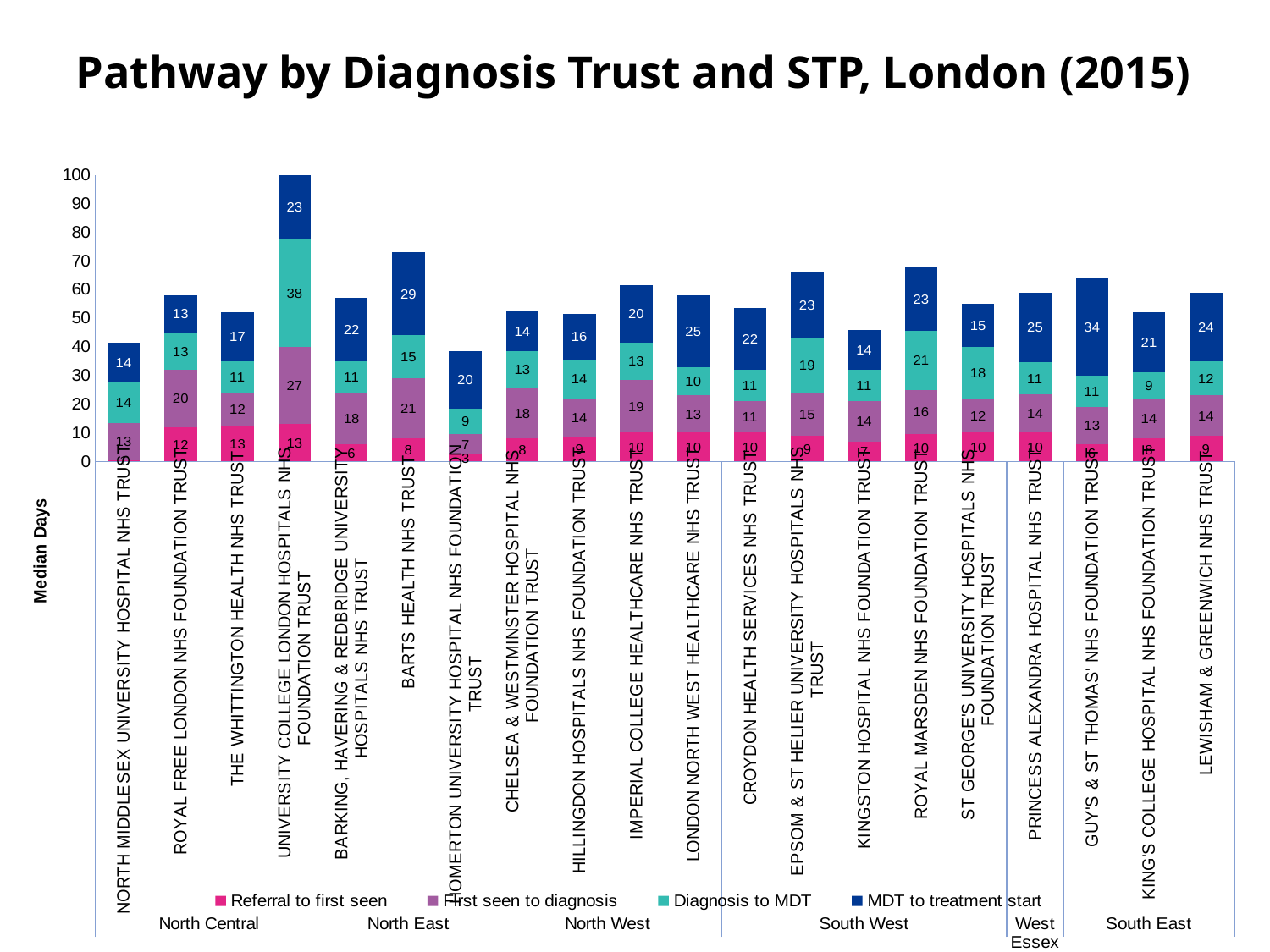
What is the First seen to diagnosis value for Royal Free London NHS Foundation Trust? 20 Which trust has the tallest stacked bar overall? University College London Hospitals NHS Foundation Trust Which trust has the smallest Referral to first seen value? North Middlesex University Hospital NHS Trust What kind of chart is shown on the slide? Stacked bar chart What is the MDT to treatment start value for Guy's & St Thomas' NHS Foundation Trust? 34 How many trusts are plotted along the x axis? 20 What is the difference between the MDT to treatment start values for Barts Health NHS Trust and Barking, Havering & Redbridge University Hospitals NHS Trust? 7 How many series does the legend list? 4 Is the total stacked bar for Homerton University Hospital NHS Foundation Trust greater or less than 50? less What is the Diagnosis to MDT value for University College London Hospitals NHS Foundation Trust? 38 Which has the larger MDT to treatment start value: Imperial College Healthcare NHS Trust or London North West Healthcare NHS Trust? London North West Healthcare NHS Trust What is the total of the stacked bar for Barts Health NHS Trust? 73